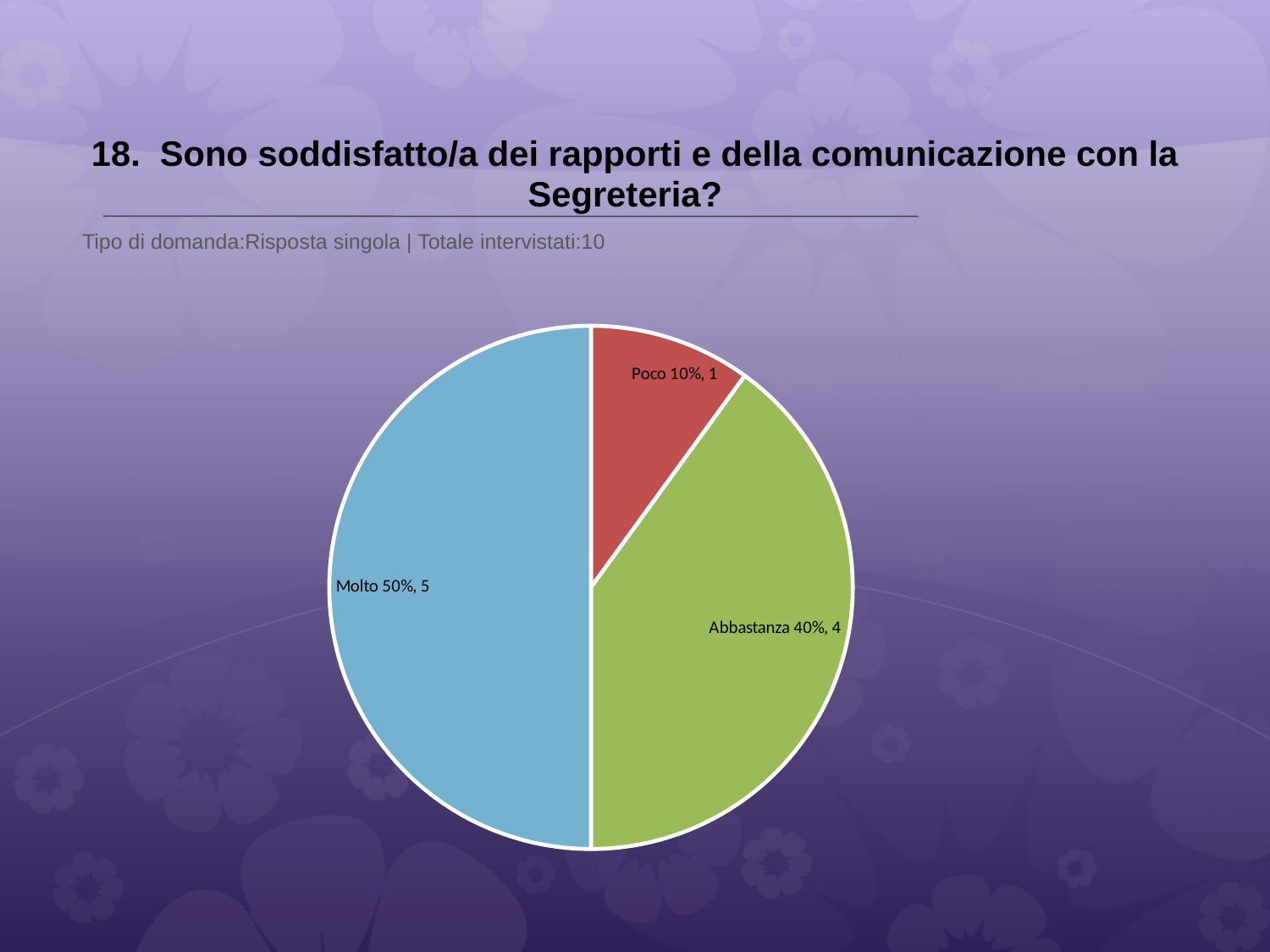
What is the difference in respondent count between Molto and Poco? 4 What percentage share does the Molto slice have? 50% How many respondents answered Abbastanza? 4 How many respondents answered Poco? 1 Which response has the smallest slice of the pie? Poco What percentage share does the Poco slice have? 10% How many respondents answered Molto? 5 How many slices does the pie chart have? 3 Which response has the largest slice of the pie? Molto Which slice is larger, Abbastanza or Poco? Abbastanza What kind of chart is shown on the slide? pie chart What percentage share does the Abbastanza slice have? 40%